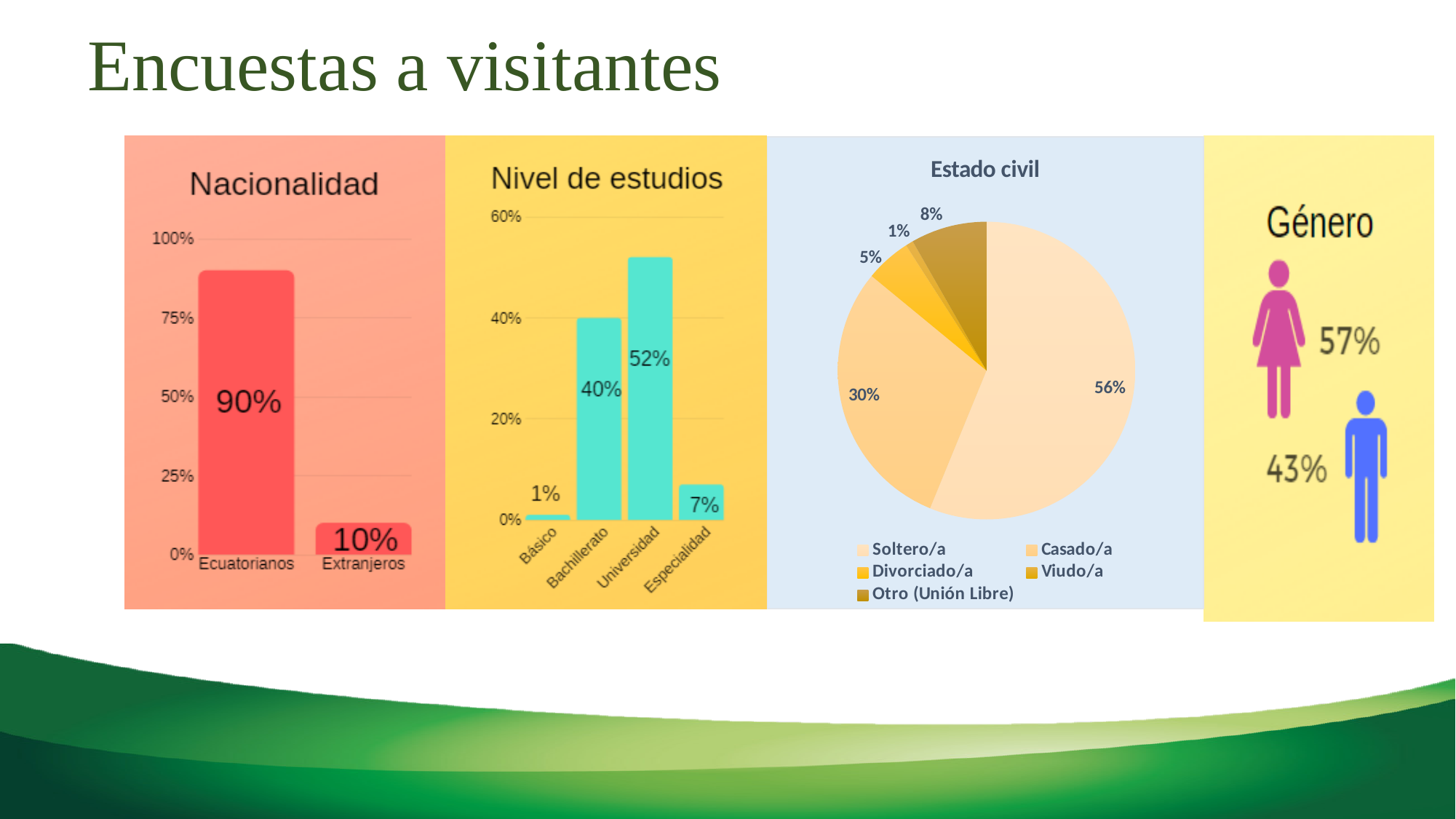
What kind of chart is the Estado civil chart? Pie chart In the Nacionalidad chart, what is the difference between the values for Ecuatorianos and Extranjeros? 80% What kind of chart is the Nacionalidad chart? Bar chart In the Estado civil chart, which category has the smallest slice? Viudo/a In the Nivel de estudios chart, which category has the highest value? Universidad In the Nivel de estudios chart, what is the difference between the values for Universidad and Bachillerato? 12% In the Nacionalidad chart, what is the value for Ecuatorianos? 90% In the Nivel de estudios chart, what is the value for Bachillerato? 40% How many entries does the legend of the Estado civil chart list? 5 In the Nivel de estudios chart, which category has the lowest value? Básico In the Estado civil chart, what share of the pie is Soltero/a? 56% How many categories are shown in the Nivel de estudios chart? 4